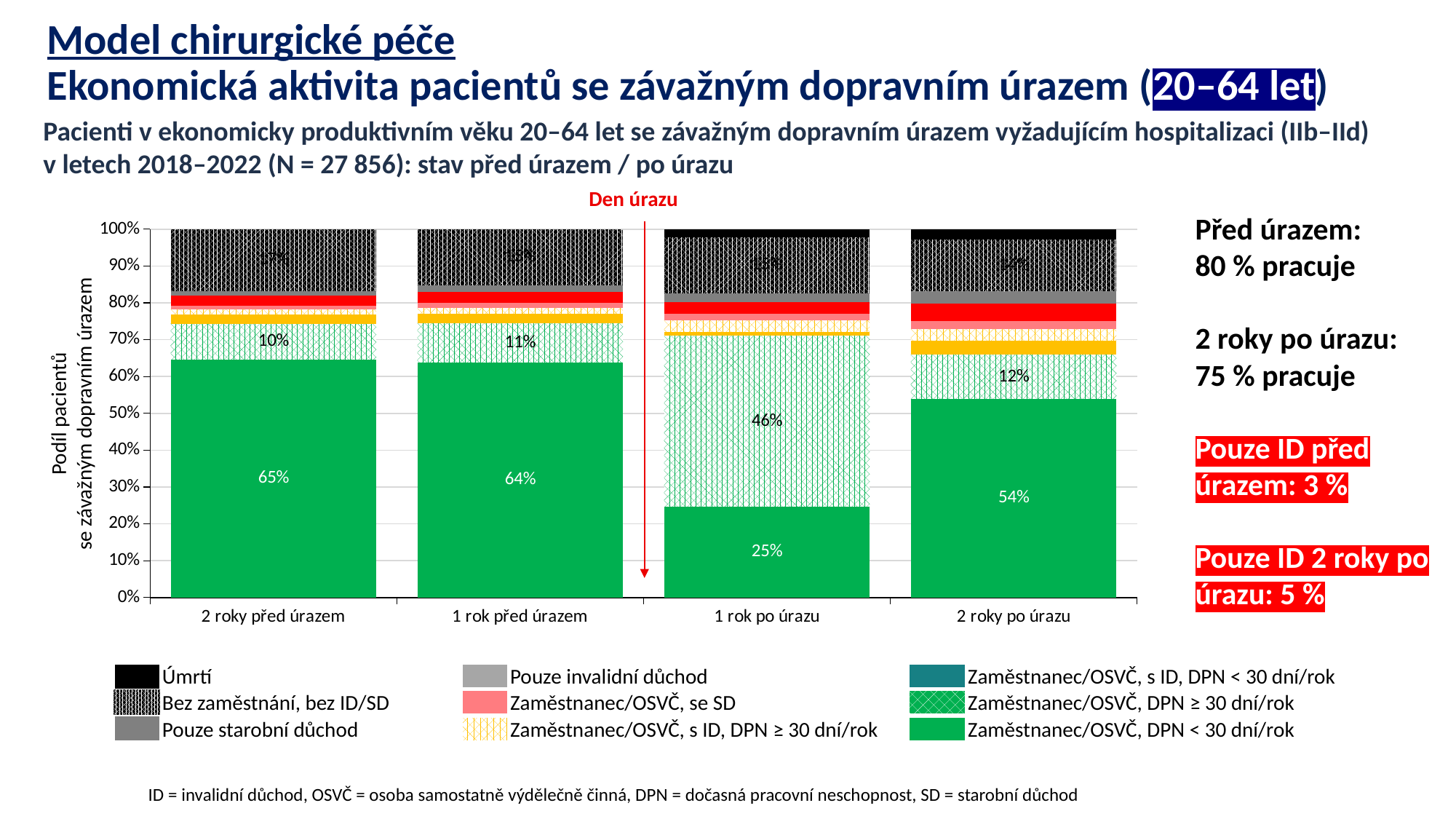
What is the difference in the share of 'Zaměstnanec/OSVČ, DPN < 30 dní/rok' between '2 roky před úrazem' and '2 roky po úrazu'? 11 percentage points What is the share of 'Zaměstnanec/OSVČ, DPN < 30 dní/rok' for '2 roky po úrazu'? 54% In which category is the share of 'Zaměstnanec/OSVČ, DPN < 30 dní/rok' lowest? 1 rok po úrazu What kind of chart is shown on the slide? Stacked bar chart Which is larger: the share of 'Zaměstnanec/OSVČ, DPN < 30 dní/rok' for '2 roky před úrazem' or for '1 rok před úrazem'? 2 roky před úrazem What does the red arrow between the second and third bars mark? Den úrazu What is the share of 'Zaměstnanec/OSVČ, DPN < 30 dní/rok' for '1 rok po úrazu'? 25% What is the share of 'Zaměstnanec/OSVČ, DPN < 30 dní/rok' for '2 roky před úrazem'? 65% How many categories are shown on the x axis of the chart? 4 What is the share of 'Zaměstnanec/OSVČ, DPN ≥ 30 dní/rok' for '2 roky po úrazu'? 12% How many series does the chart legend list? 9